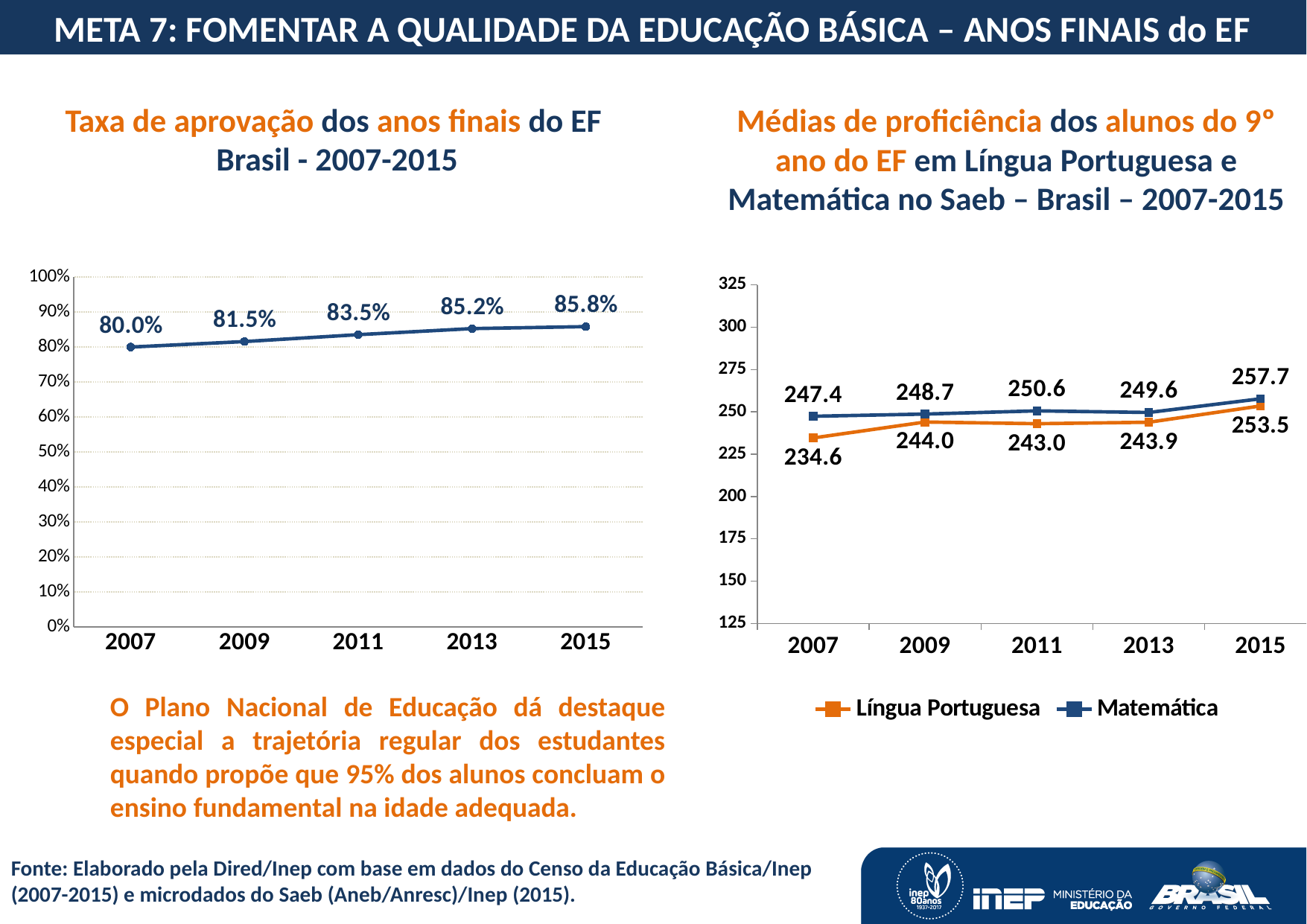
In the right chart (Médias de proficiência), what is the difference between Matemática and Língua Portuguesa in 2011? 7.6 In the right chart (Médias de proficiência), what is the Matemática average in 2015? 257.7 In the right chart (Médias de proficiência), which is larger in 2007: Língua Portuguesa or Matemática? Matemática In the left chart (Taxa de aprovação dos anos finais do EF), which year has the highest approval rate? 2015 In the left chart (Taxa de aprovação dos anos finais do EF), how many years are plotted? 5 In the left chart (Taxa de aprovação dos anos finais do EF), do the values rise or fall from 2007 to 2015? rise In the left chart (Taxa de aprovação dos anos finais do EF), which year has the lowest approval rate? 2007 In the right chart (Médias de proficiência), what is the Língua Portuguesa average in 2013? 243.9 In the left chart (Taxa de aprovação dos anos finais do EF), what is the approval rate for 2011? 83.5% What kind of chart is the right chart (Médias de proficiência)? line chart In the left chart (Taxa de aprovação dos anos finais do EF), what is the difference between the 2015 and 2007 values? 5.8% In the right chart (Médias de proficiência), how many series does the legend list? 2